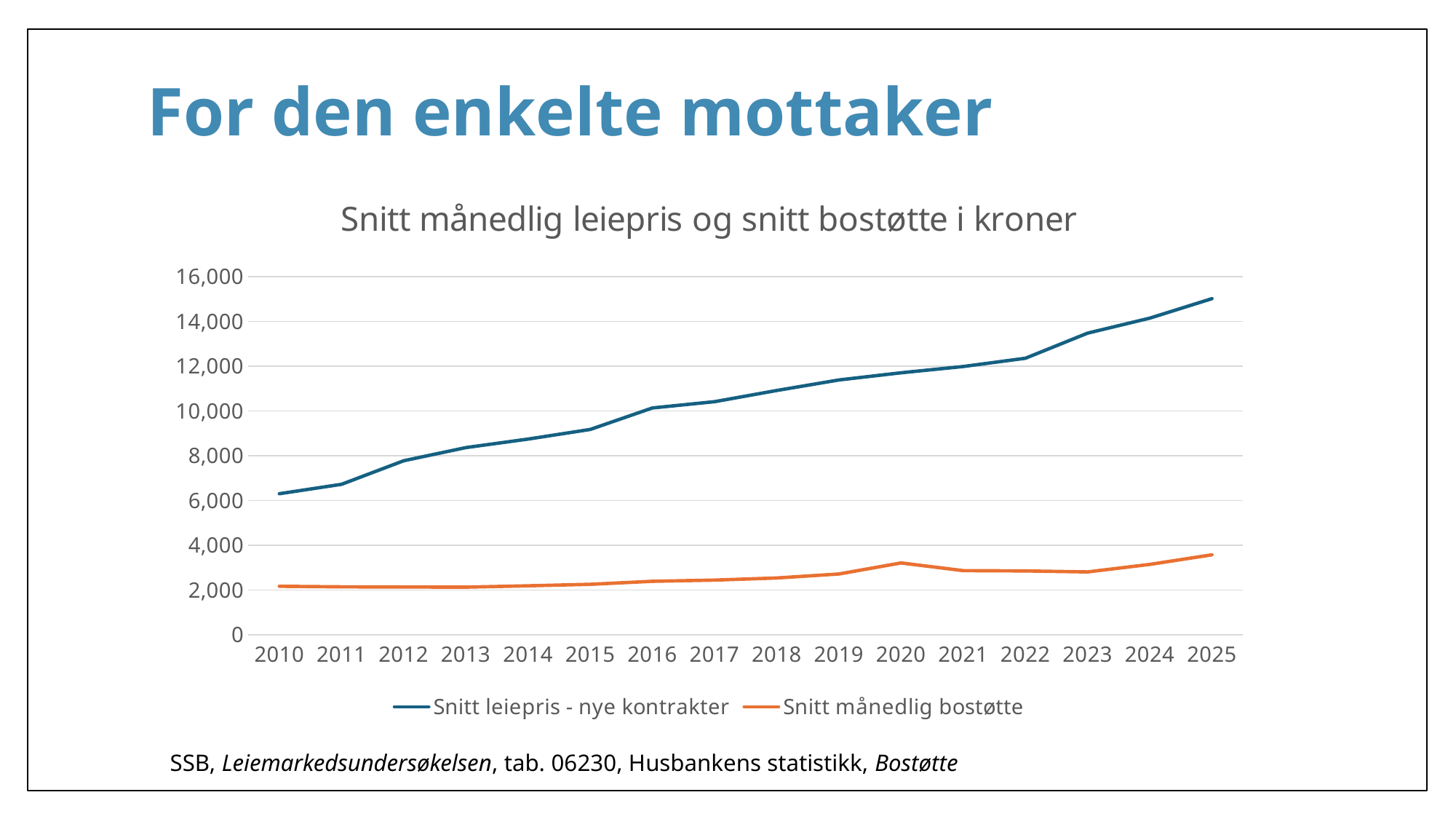
How many years are plotted along the x axis? 16 Is the value for Snitt leiepris - nye kontrakter in 2025 greater or less than 14,000? greater In which year is Snitt månedlig bostøtte highest? 2025 In which year is Snitt leiepris - nye kontrakter highest? 2025 In which year is Snitt leiepris - nye kontrakter lowest? 2010 What kind of chart is shown on the slide? line chart Is the value for Snitt leiepris - nye kontrakter in 2010 greater or less than 8,000? less Is the value for Snitt månedlig bostøtte in 2020 greater or less than 4,000? less Which series is drawn in orange? Snitt månedlig bostøtte What is the title of the chart? Snitt månedlig leiepris og snitt bostøtte i kroner How many series does the legend list? 2 Does Snitt leiepris - nye kontrakter rise or fall from 2010 to 2025? rise